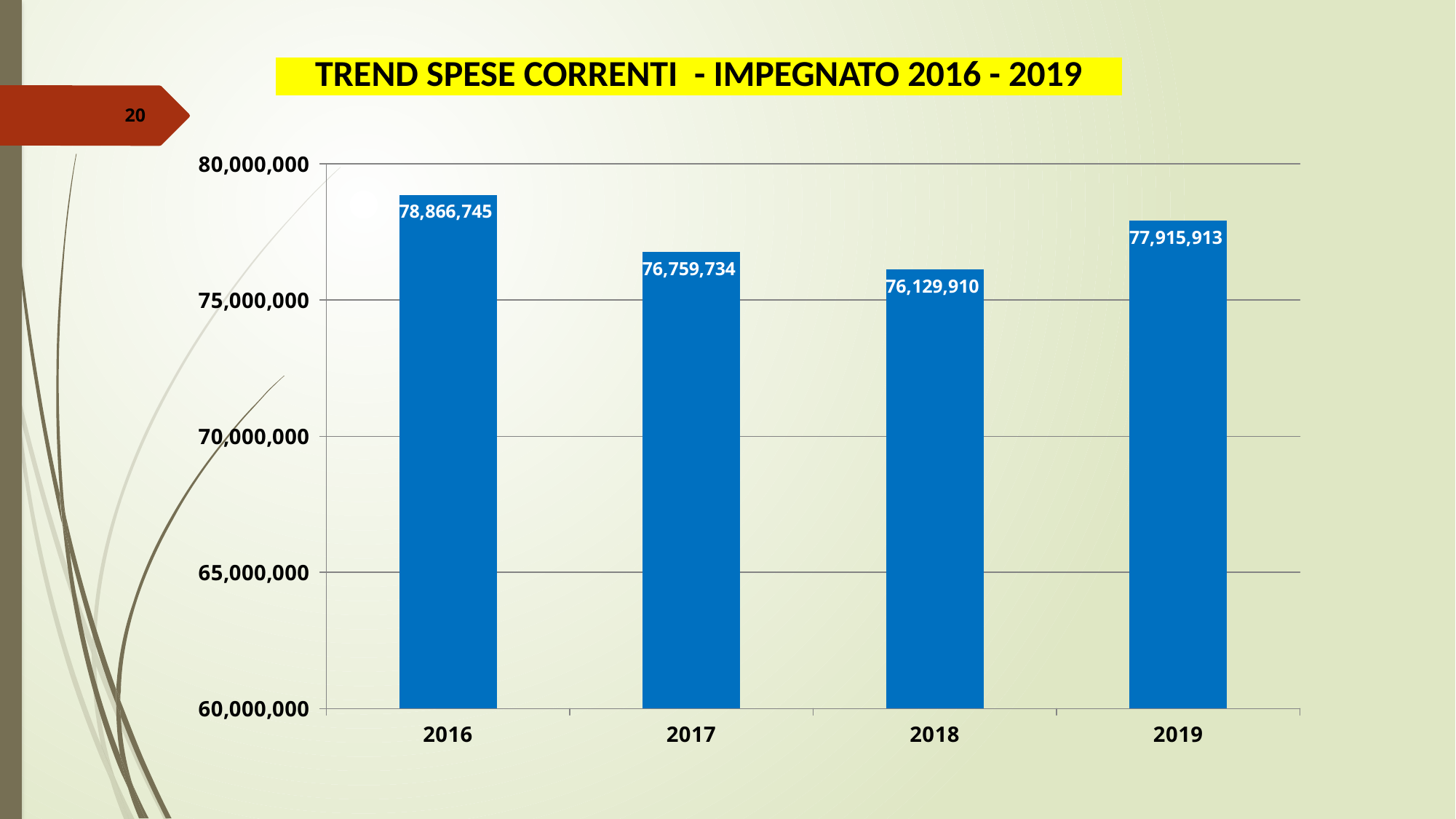
How many years are shown on the x axis? 4 Which year has the highest value? 2016 What kind of chart is shown on the slide? bar chart What is the value for 2016? 78,866,745 What is the value for 2018? 76,129,910 What is the value for 2019? 77,915,913 What is the difference between the values for 2019 and 2018? 1,786,003 What is the difference between the values for 2016 and 2017? 2,107,011 Is the value for 2018 greater or less than 75,000,000? greater Which is larger, the value for 2017 or the value for 2019? 2019 Which year has the lowest value? 2018 Do the values rise or fall from 2016 to 2018? fall